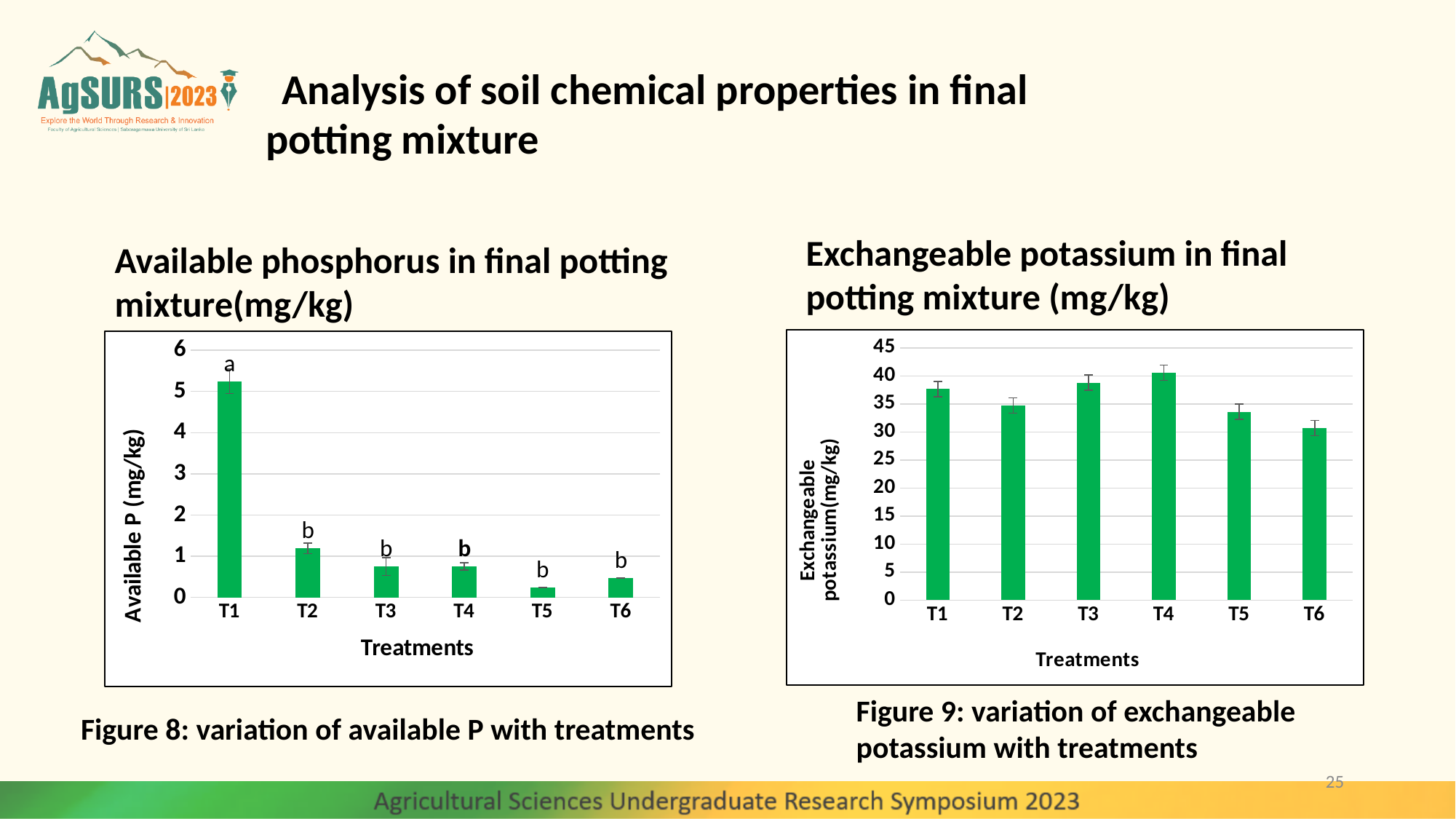
In the Exchangeable potassium chart, is the value for T2 greater or less than 30? greater In the Available phosphorus chart, is the value for T3 greater or less than 1? less In the Exchangeable potassium chart, which treatment has the highest exchangeable potassium? T4 In the Exchangeable potassium chart, which treatment has the lowest exchangeable potassium? T6 What kind of chart is the Exchangeable potassium chart? bar chart In the Available phosphorus chart, what letter is printed above the T1 bar? a In the Available phosphorus chart, which treatment has the highest available P? T1 In the Available phosphorus chart, which is larger, the value for T2 or the value for T6? T2 In the Available phosphorus chart, which treatment has the lowest available P? T5 In the Exchangeable potassium chart, which is larger, the value for T1 or the value for T5? T1 In the Available phosphorus chart, is the value for T1 greater or less than 5? greater How many treatments are shown on the x axis of the Available phosphorus chart? 6